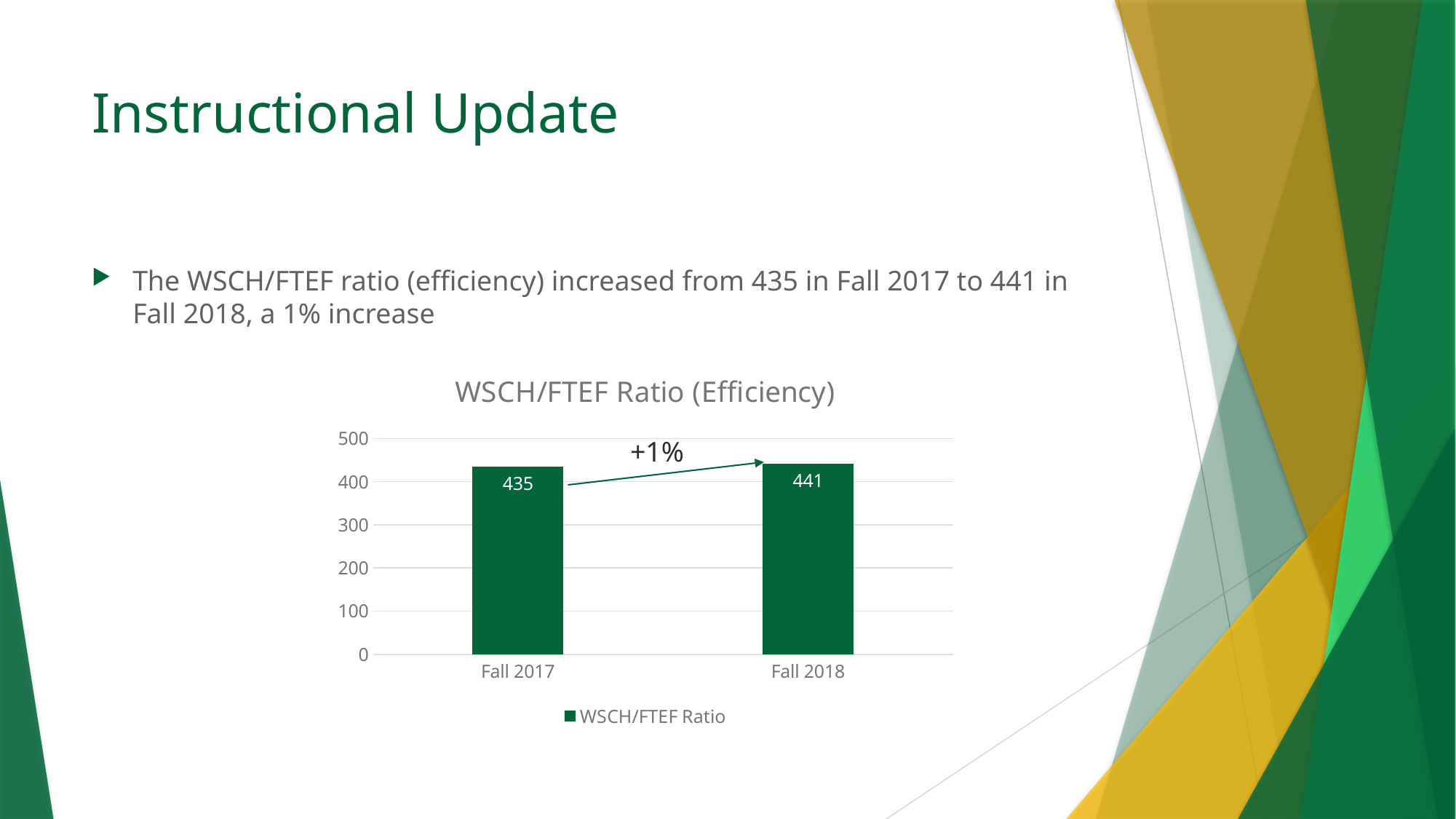
How many series does the chart legend list? 1 Does the WSCH/FTEF Ratio rise or fall from Fall 2017 to Fall 2018? Rise What is the WSCH/FTEF Ratio for Fall 2018? 441 Which period has the higher WSCH/FTEF Ratio? Fall 2018 How many categories are shown on the x axis of the chart? 2 What is the title of the chart? WSCH/FTEF Ratio (Efficiency) What kind of chart is shown on the slide? Bar chart Is the WSCH/FTEF Ratio for Fall 2017 greater or less than 400? greater What is the difference between the Fall 2018 and Fall 2017 WSCH/FTEF Ratio values? 6 Which period has the lower WSCH/FTEF Ratio? Fall 2017 Is the WSCH/FTEF Ratio for Fall 2018 greater or less than 500? less What is the WSCH/FTEF Ratio for Fall 2017? 435